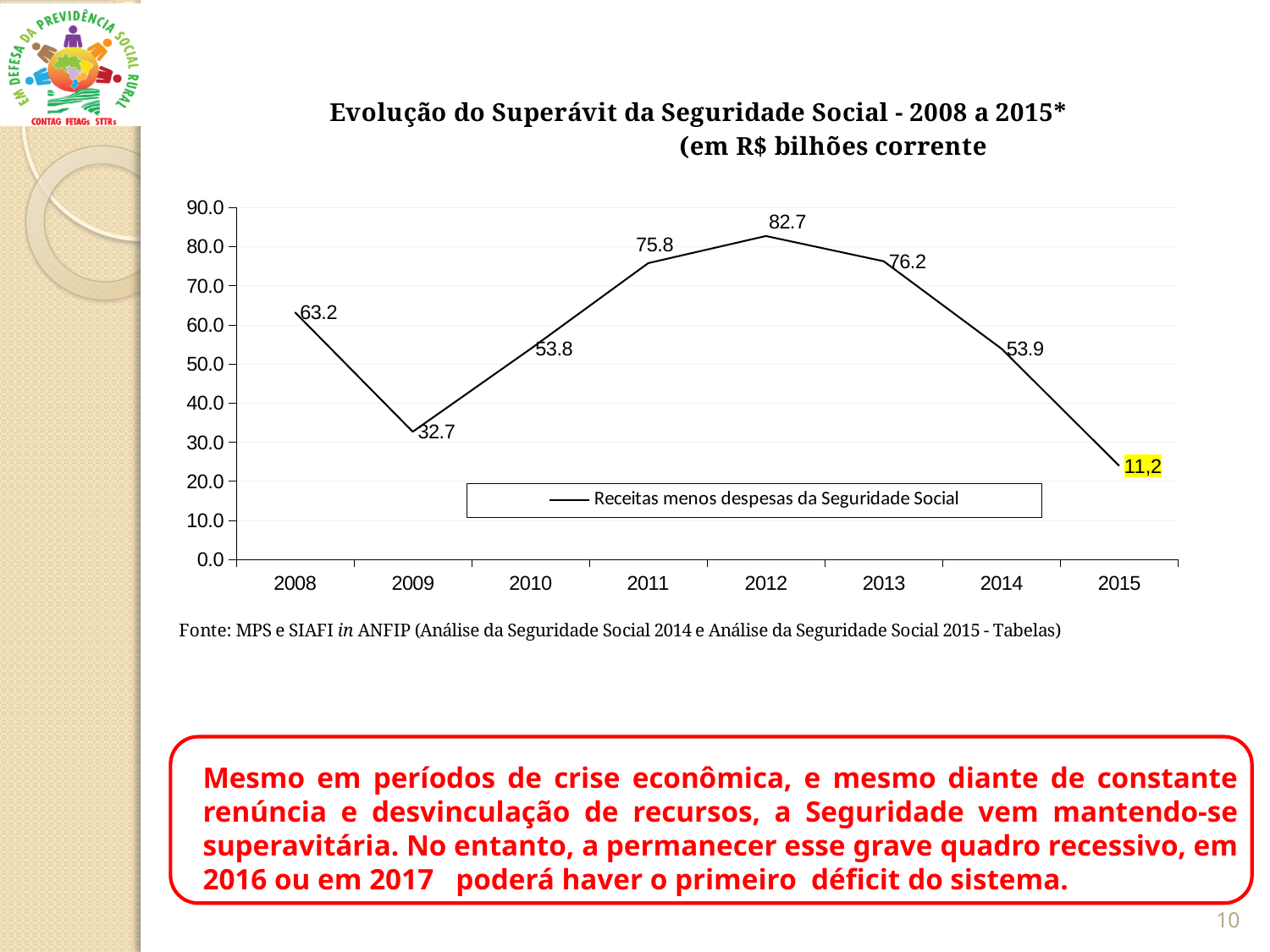
What is the value for 2015? 11,2 What is the difference between the values for 2008 and 2009? 30.5 What type of chart is shown on the slide? Line chart Which year has the highest value? 2012 Which year has the lowest value? 2015 What is the difference between the values for 2012 and 2011? 6.9 What is the value for 2009? 32.7 Does the value rise or fall from 2012 to 2015? Fall What is the value for 2012? 82.7 What series name does the legend show? Receitas menos despesas da Seguridade Social How many years are plotted on the x axis? 8 Which is larger, the value for 2013 or the value for 2014? 2013